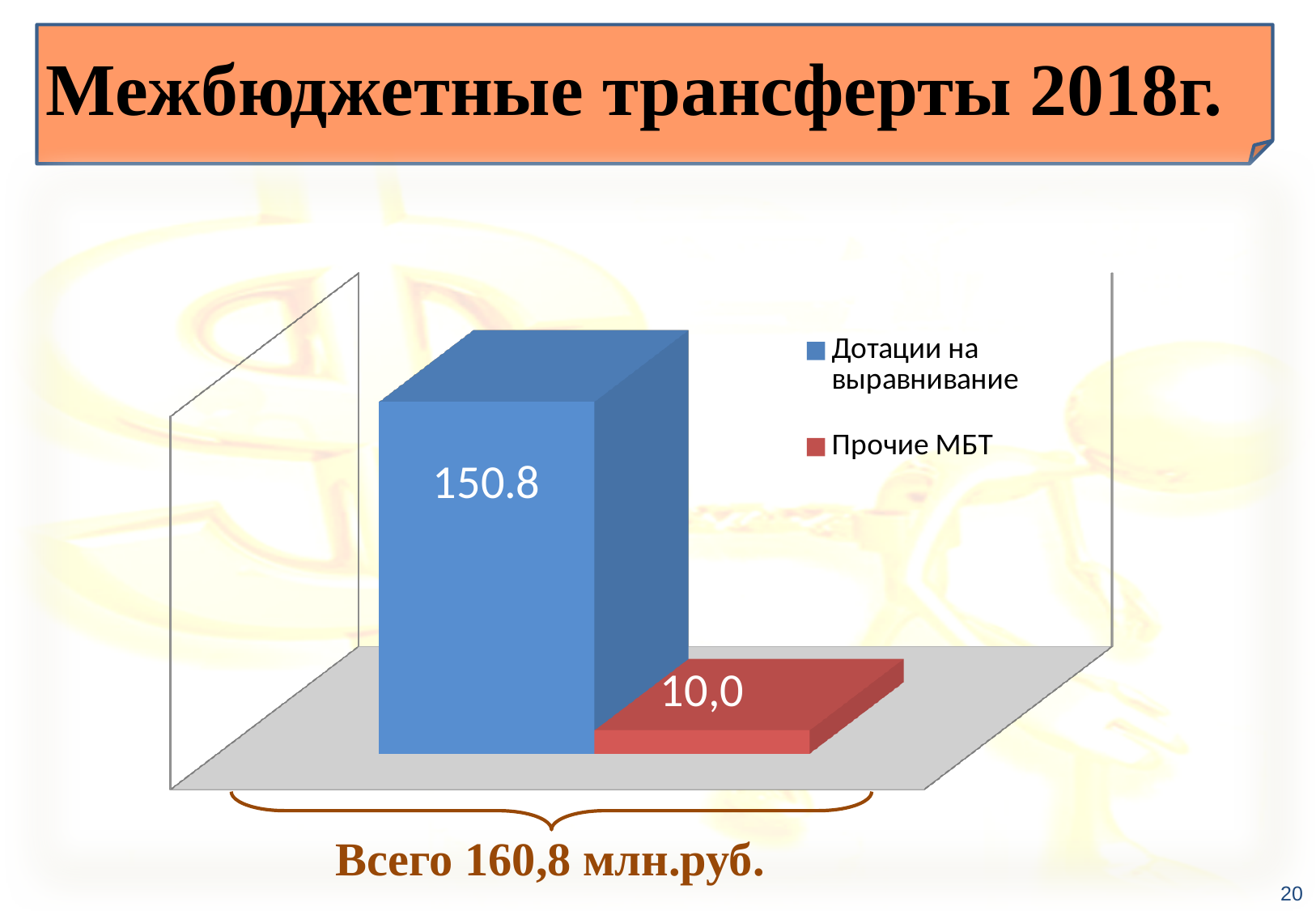
Which series has the highest value? Дотации на выравнивание What total is stated below the chart? 160,8 млн.руб. Which series has the lowest value? Прочие МБТ What value is shown for Дотации на выравнивание? 150.8 What is the title of the slide? Межбюджетные трансферты 2018г. How many bars are plotted in the chart? 2 What value is shown for Прочие МБТ? 10,0 Which is larger: Дотации на выравнивание or Прочие МБТ? Дотации на выравнивание What colour is the bar for Прочие МБТ? red What is the difference between the value for Дотации на выравнивание and the value for Прочие МБТ? 140.8 What kind of chart is shown on the slide? bar chart How many series does the legend list? 2